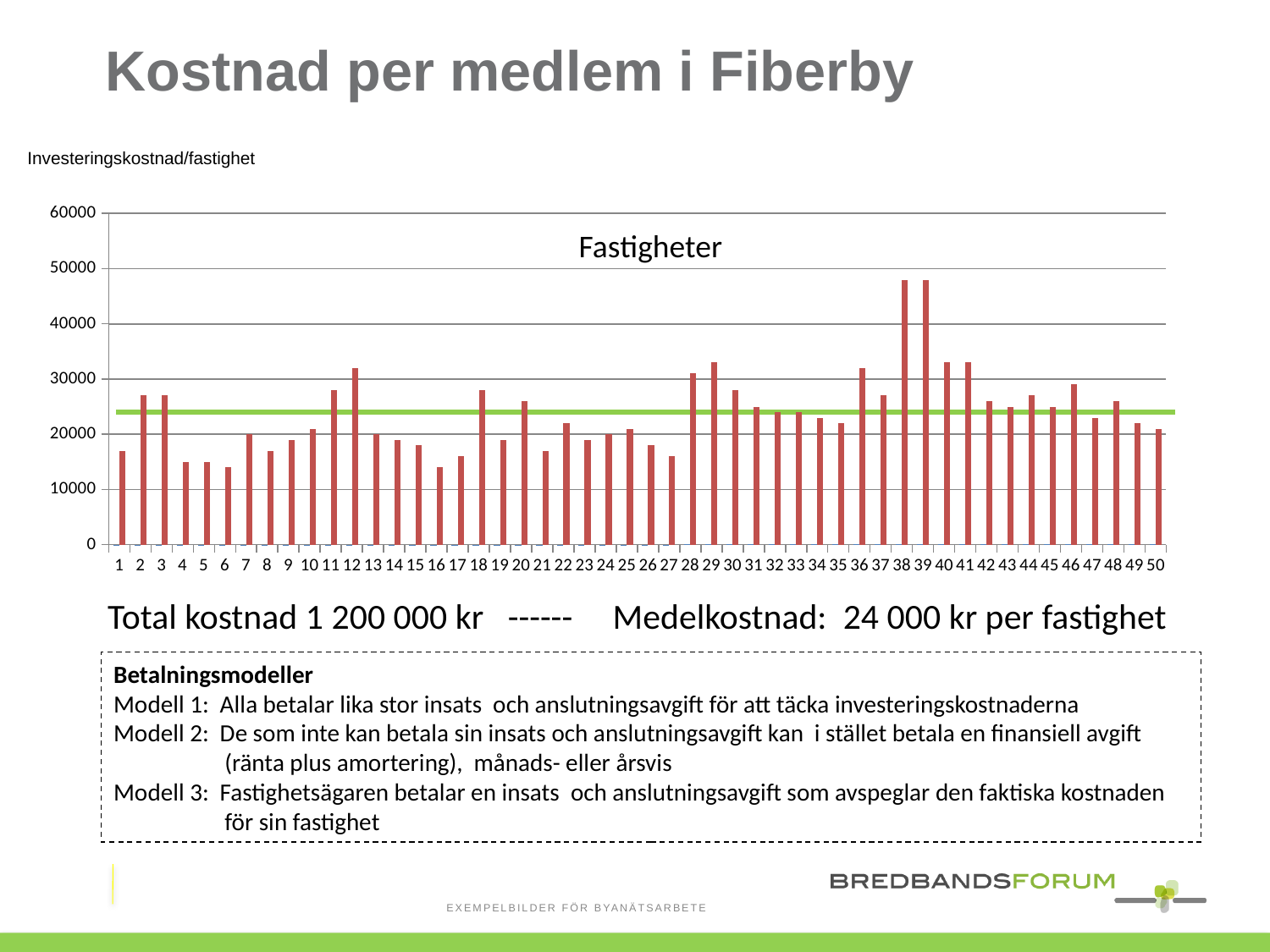
Is the value for fastighet 1 greater or less than 20000? less Is the value for fastighet 38 greater or less than 40000? greater How many categories (fastigheter) are plotted along the x axis? 50 What kind of chart is shown on the slide? bar chart Which has the larger value, fastighet 12 or fastighet 13? fastighet 12 Is the value for fastighet 27 greater or less than 20000? less Which has the larger value, fastighet 39 or fastighet 40? fastighet 39 What is the highest value shown on the y axis? 60000 What is the title shown inside the chart? Fastigheter